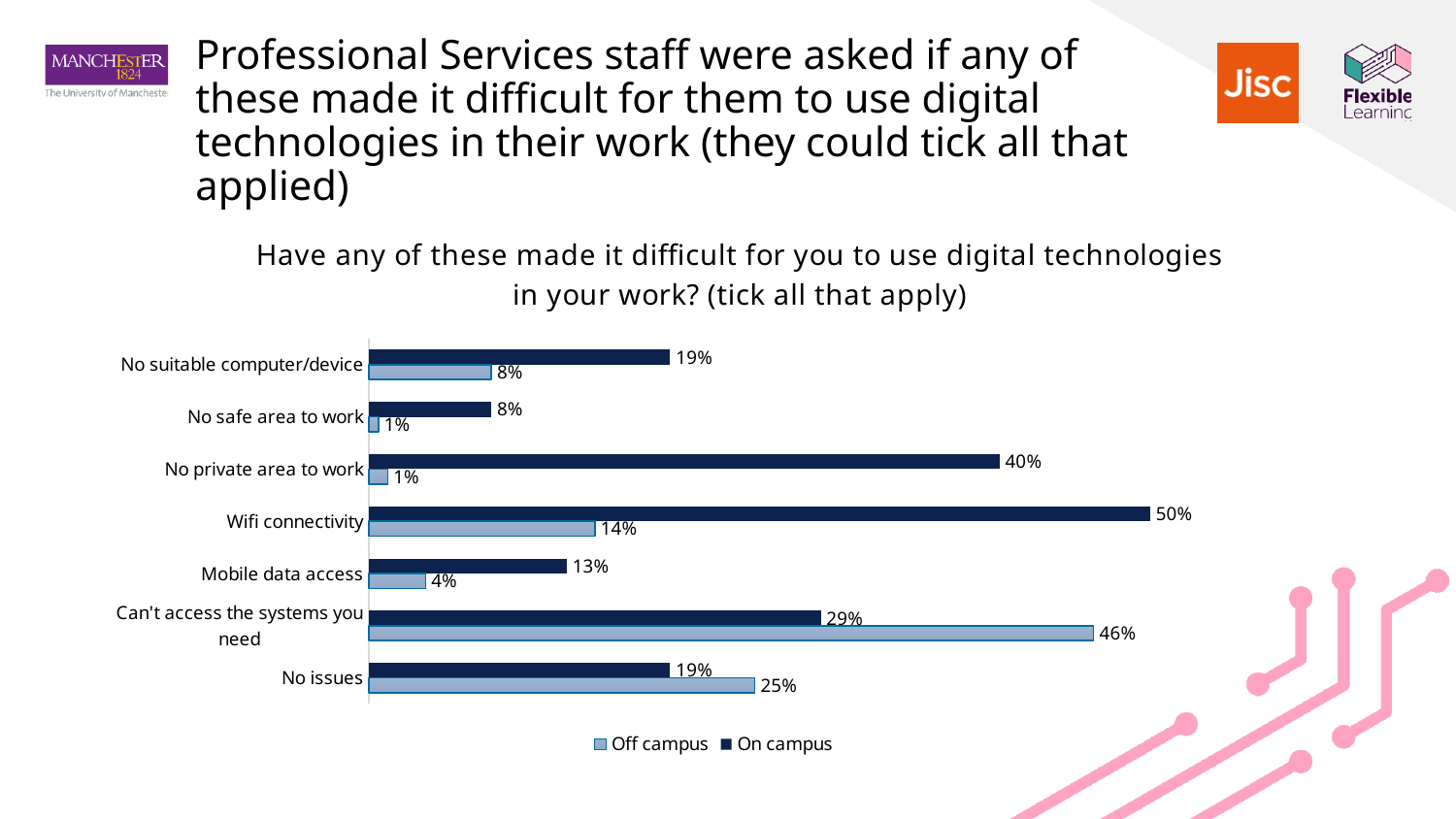
Which series is shown in dark navy according to the legend? On campus For "No issues", which is larger: the On campus value or the Off campus value? Off campus What percentage of On campus respondents cited Wifi connectivity as a difficulty? 50% What is the Off campus value for "Can't access the systems you need"? 46% What type of chart is shown on the slide? Bar chart What is the difference between the On campus and Off campus values for Wifi connectivity? 36% What is the On campus value for "Mobile data access"? 13% Which category has the highest On campus value? Wifi connectivity Which category has the highest Off campus value? Can't access the systems you need What is the Off campus value for "No private area to work"? 1% How many categories are shown on the chart? 7 How many series does the legend list? 2